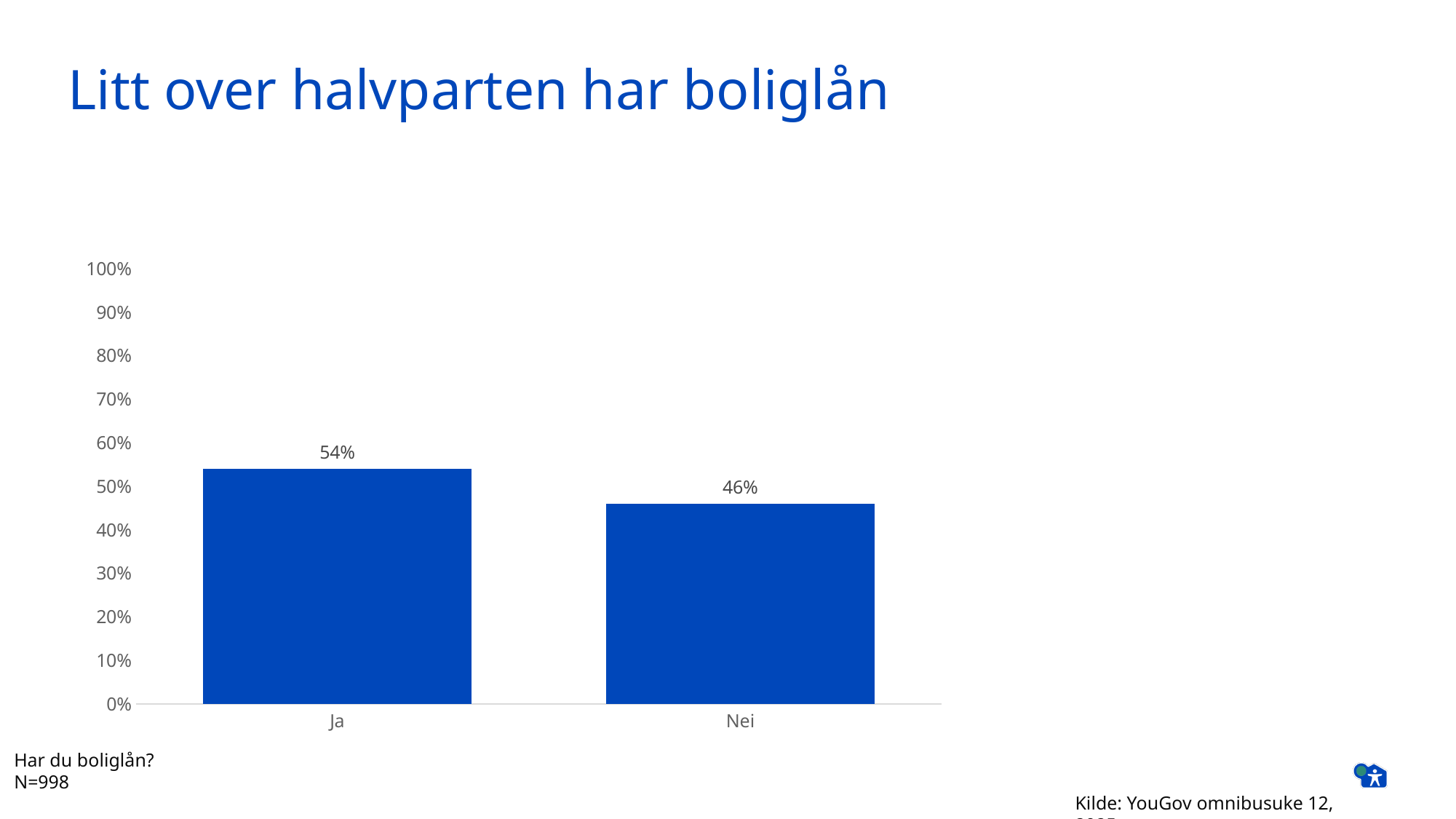
What kind of chart is shown on the slide? bar chart Which category has the lowest value? Nei What is the value for Ja? 54% Which category has the highest value? Ja Which is larger, the value for Ja or the value for Nei? Ja Is the value for Ja greater or less than 50%? greater Is the value for Nei greater or less than 50%? less How many categories are shown on the x axis? 2 What is the sample size (N) stated below the chart? N=998 What is the difference between the values for Ja and Nei? 8% What is the title of the slide? Litt over halvparten har boliglån What is the value for Nei? 46%